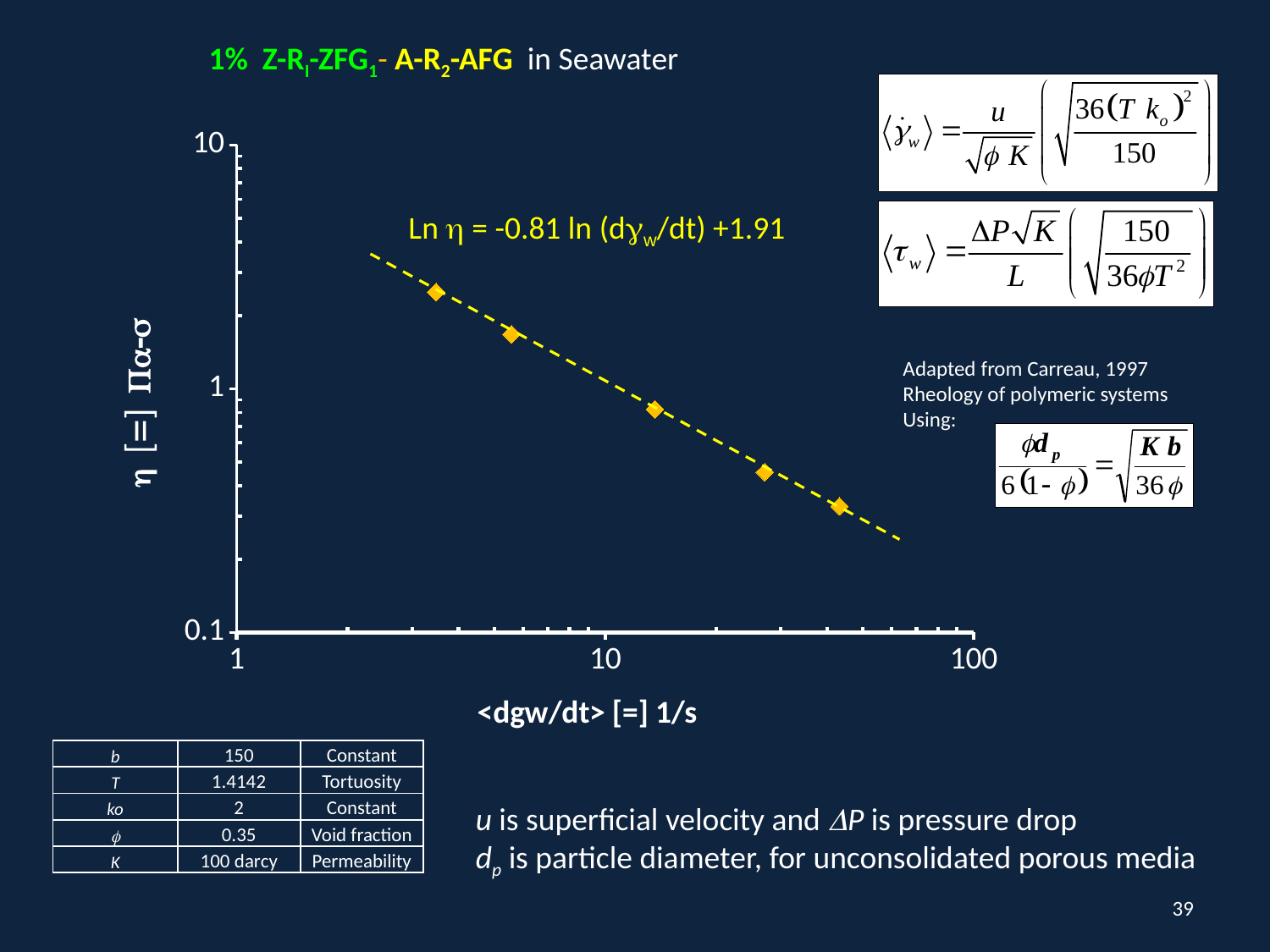
How many data points are plotted on the chart? 5 Do the plotted values rise or fall as the x-axis value increases? fall Which data point has the highest y value, the leftmost or the rightmost? leftmost What slope is given in the fitted line equation shown on the chart? -0.81 Is the x value of the rightmost data point greater or less than 10? greater Is the y value of the leftmost data point greater or less than 1? greater What is the highest value shown on the y axis? 10 Is the y value of the rightmost data point greater or less than 1? less What is the x-axis label of the chart? <dgw/dt> [=] 1/s What is the intercept in the fitted line equation shown on the chart? 1.91 What kind of chart is shown on the slide? scatter chart